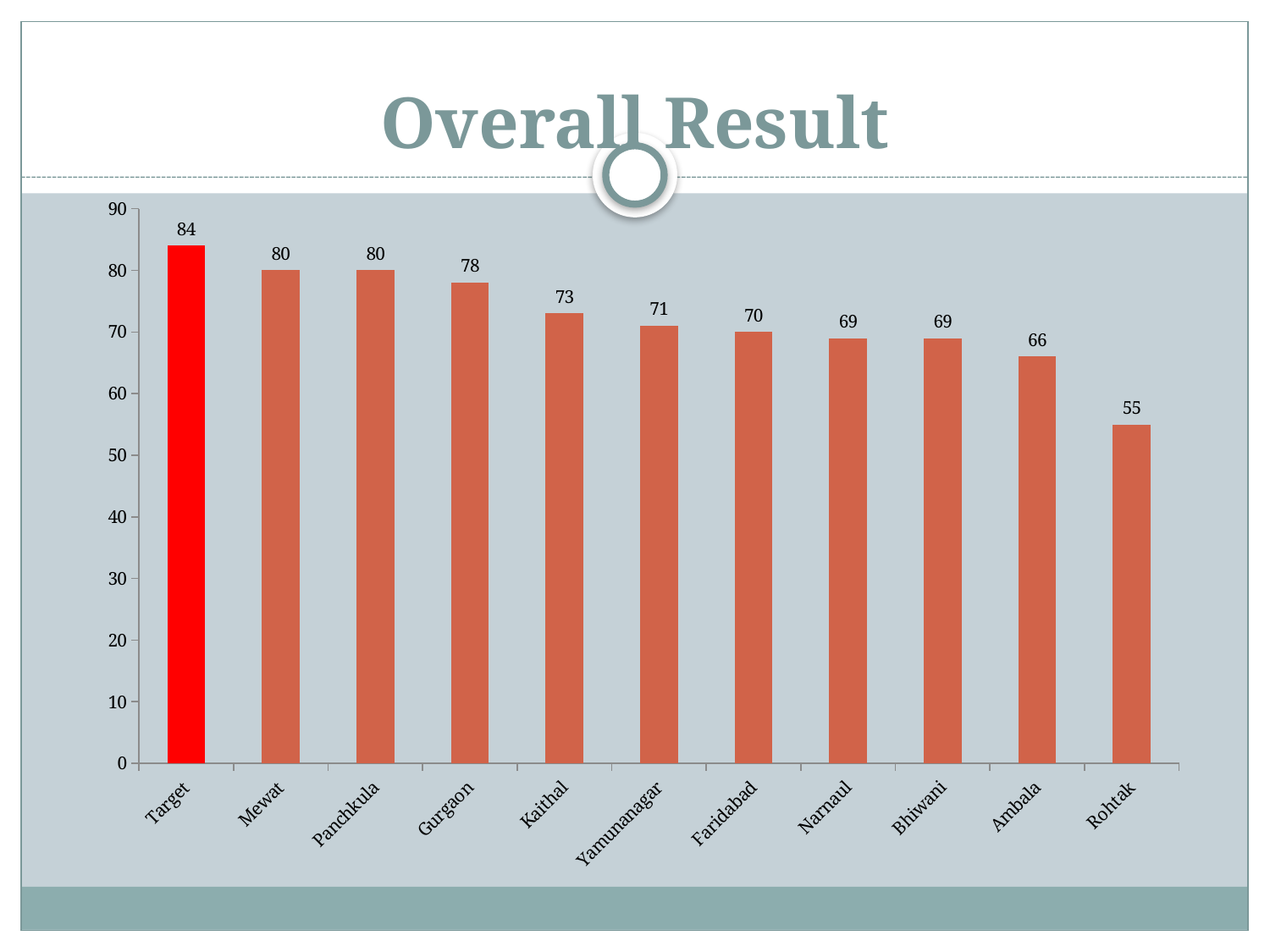
What is the difference between the values for Gurgaon and Rohtak? 23 What is the value for Ambala? 66 What is the value for Rohtak? 55 What is the title of the slide? Overall Result Which is larger, the value for Yamunanagar or the value for Ambala? Yamunanagar What kind of chart is shown on the slide? Bar chart What is the value for Target? 84 How many categories are shown on the x axis? 11 What is the value for Kaithal? 73 Which category has the lowest value? Rohtak Which category has the highest value? Target What is the difference between the values for Target and Mewat? 4